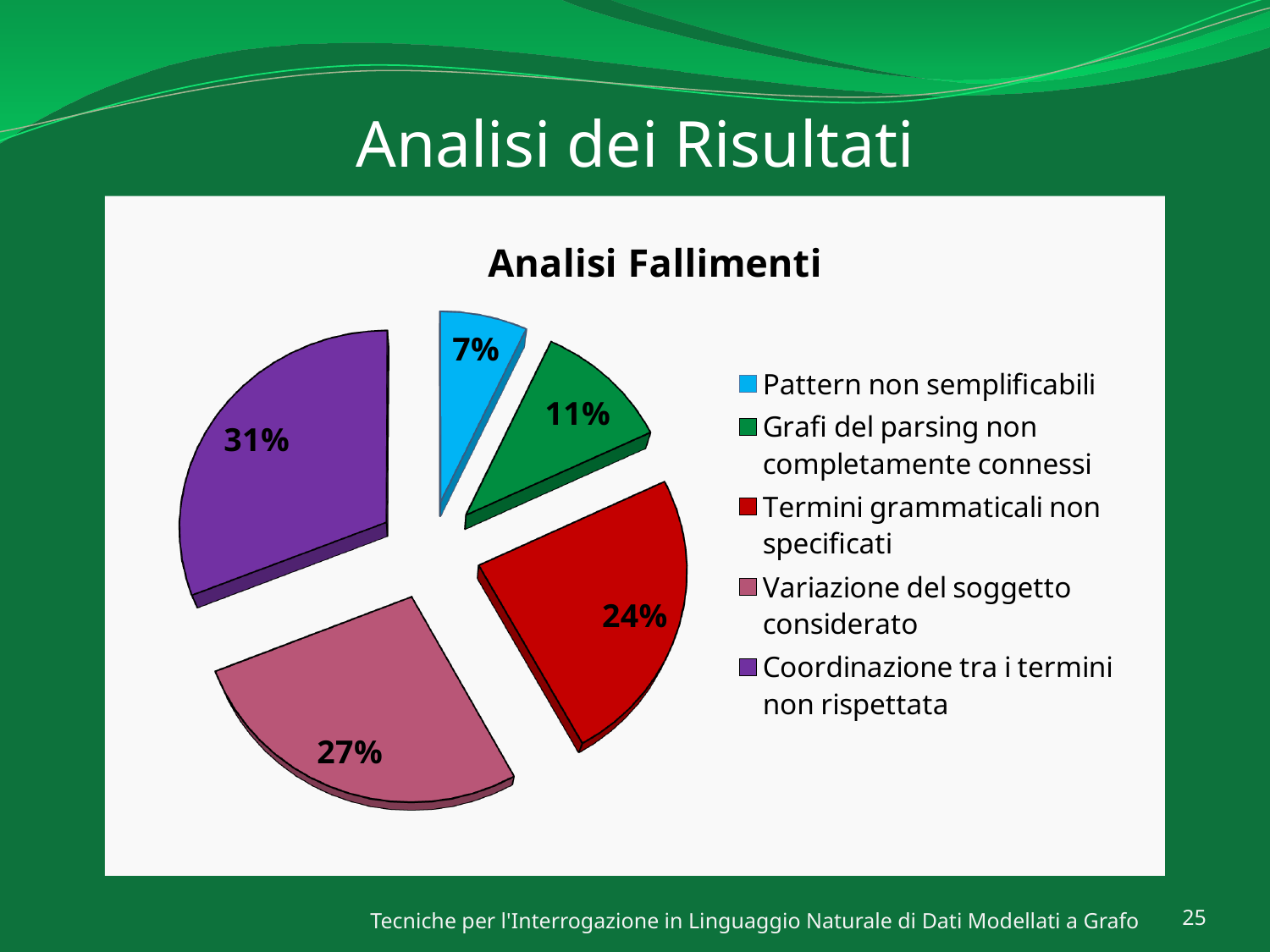
What is the difference in percentage points between 'Coordinazione tra i termini non rispettata' and 'Termini grammaticali non specificati'? 7 What percentage is shown for 'Termini grammaticali non specificati'? 24% What percentage is shown for 'Variazione del soggetto considerato'? 27% Which category has the smallest share of the pie? Pattern non semplificabili What type of chart is shown on the slide? Pie chart What percentage is shown for 'Pattern non semplificabili'? 7% What percentage is shown for 'Coordinazione tra i termini non rispettata'? 31% Which is larger: the share for 'Variazione del soggetto considerato' or for 'Grafi del parsing non completamente connessi'? Variazione del soggetto considerato What is the title of the chart? Analisi Fallimenti What percentage is shown for 'Grafi del parsing non completamente connessi'? 11% How many categories does the legend list? 5 Which category has the largest share of the pie? Coordinazione tra i termini non rispettata